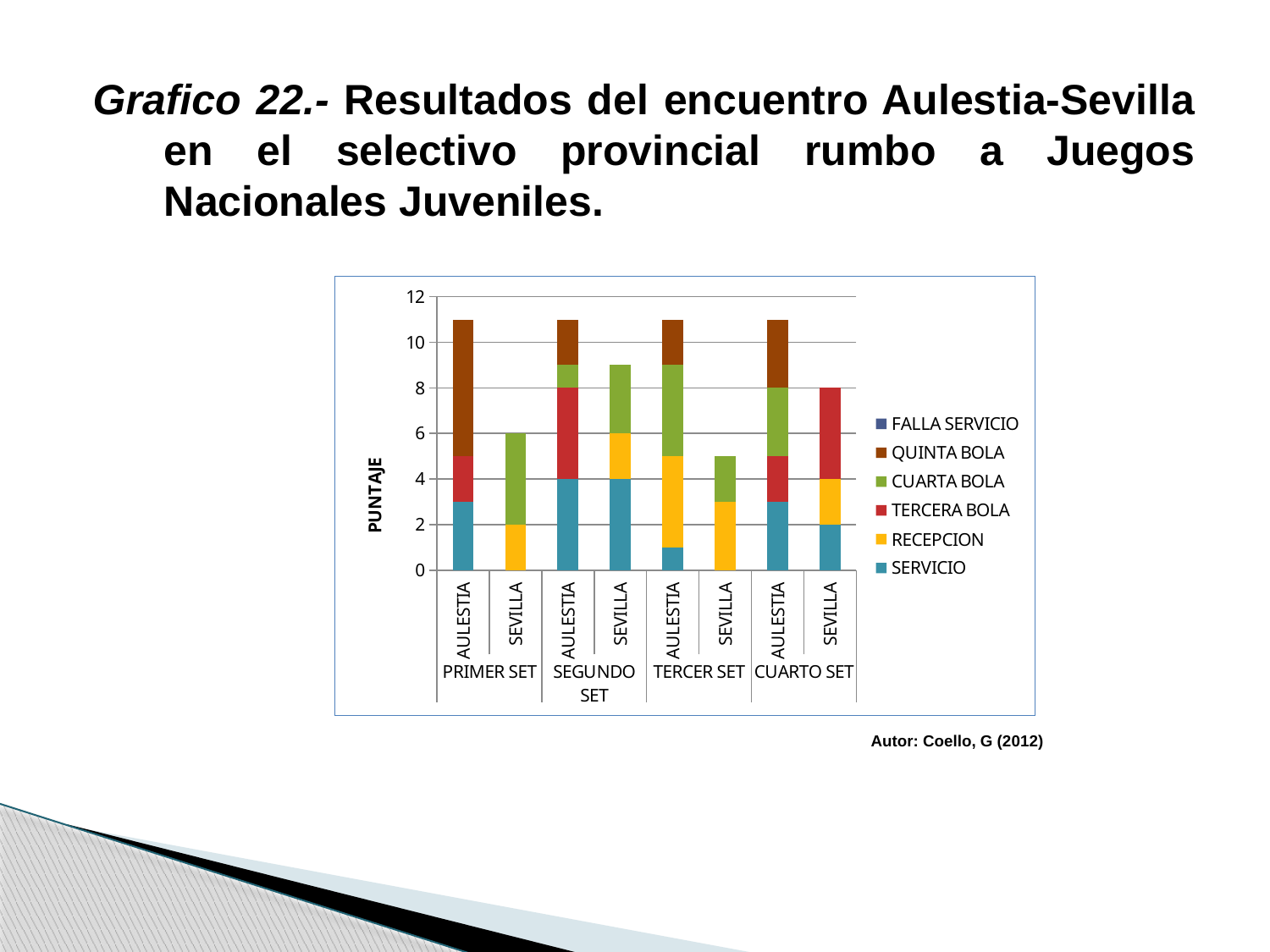
Which SEVILLA bar is the lowest across the four sets? TERCER SET How many series does the legend list? 6 What kind of chart is shown on the slide? stacked bar chart What is the SERVICIO value for SEVILLA in CUARTO SET? 2 How many bars are plotted in the chart? 8 Which bar is taller in TERCER SET, AULESTIA or SEVILLA? AULESTIA What is the label of the vertical axis? PUNTAJE What is the SERVICIO value for AULESTIA in SEGUNDO SET? 4 Is the total for SEVILLA in TERCER SET greater or less than 6? less What is the total height of the SEVILLA bar in PRIMER SET? 6 What is the total height of the SEVILLA bar in CUARTO SET? 8 Is the total for AULESTIA in PRIMER SET greater or less than 10? greater